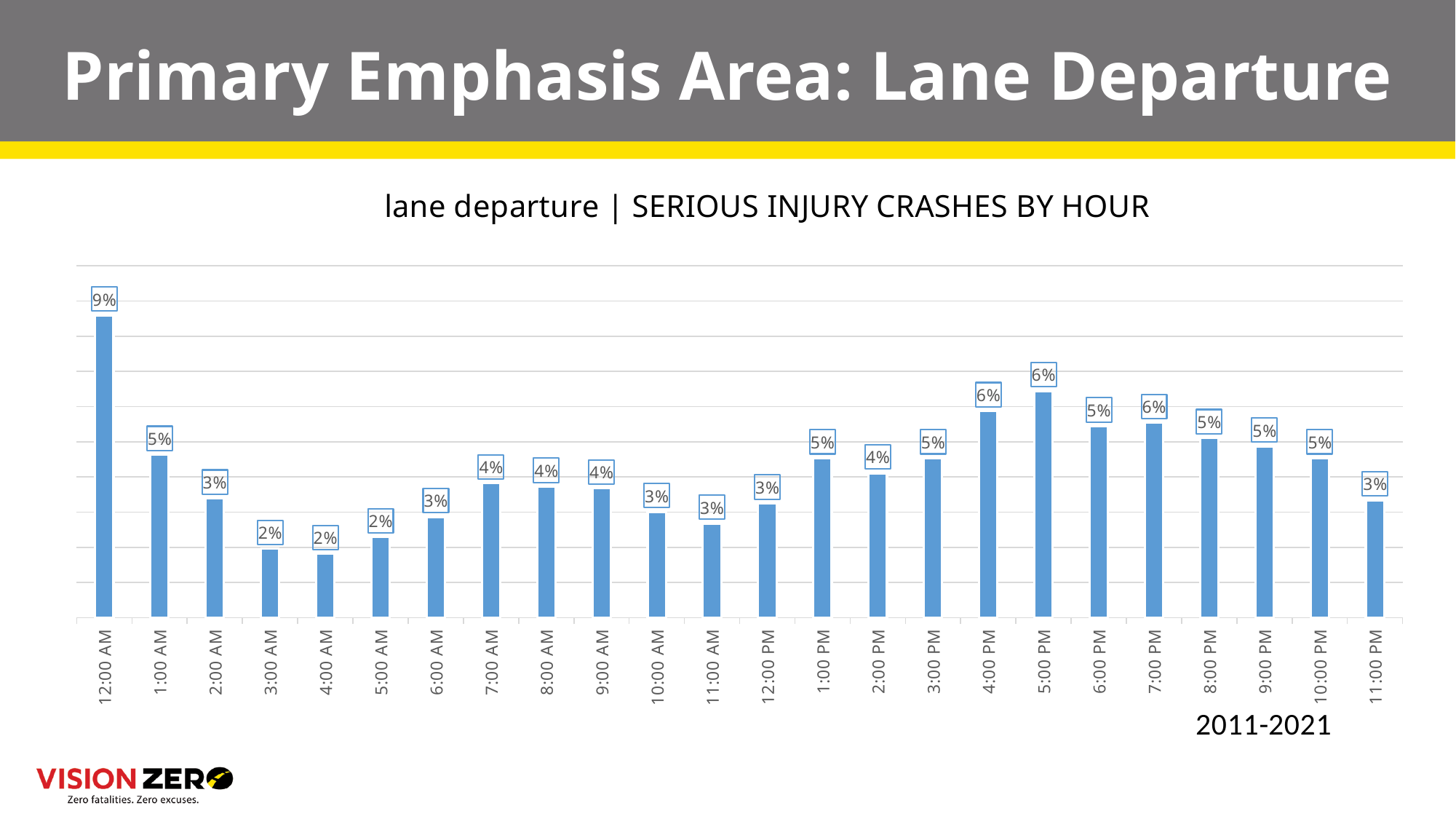
What kind of chart is shown on the slide? Bar chart Do the values rise or fall from 12:00 AM to 4:00 AM? Fall What is the difference between the values for 12:00 AM and 1:00 AM? 4 percentage points What is the value for 11:00 PM? 3% What year range does the chart cover? 2011-2021 What is the value for 5:00 PM? 6% Which is larger, the value for 12:00 AM or the value for 5:00 PM? 12:00 AM What is the value for 7:00 AM? 4% What is the value for 12:00 AM? 9% Which hour has the highest share of serious injury crashes? 12:00 AM How many hour categories are shown on the x axis? 24 What is the lowest value shown on the chart? 2%